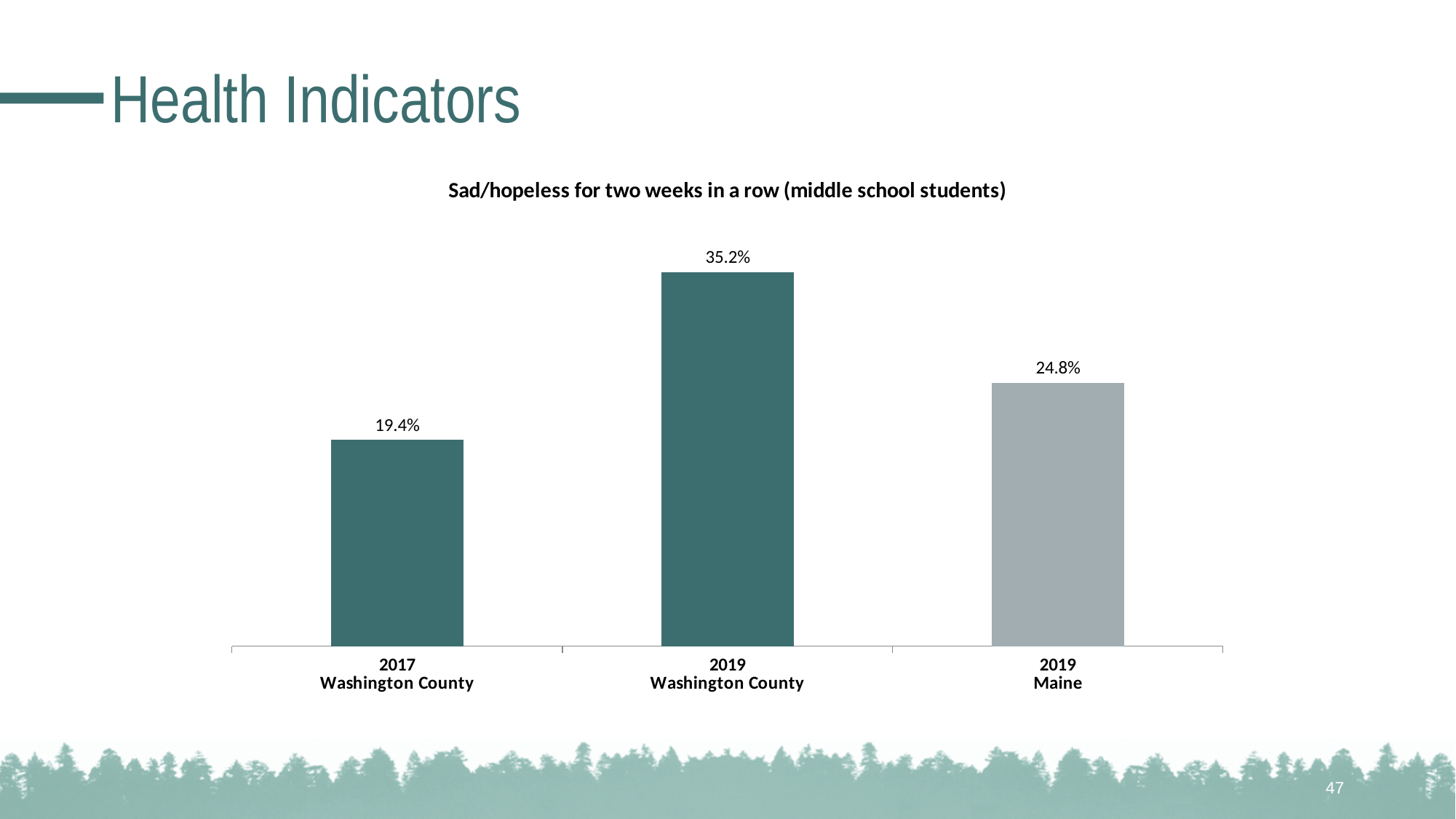
What kind of chart is shown on the slide? Bar chart Did the Washington County value rise or fall from 2017 to 2019? Rise What is the value for 2019 Maine? 24.8% What is the difference between the 2019 Washington County value and the 2017 Washington County value? 15.8% Which is larger, the value for 2019 Maine or the value for 2017 Washington County? 2019 Maine Which category has the lowest value? 2017 Washington County What is the difference between the 2019 Washington County value and the 2019 Maine value? 10.4% Which category has the highest value? 2019 Washington County What is the value for 2019 Washington County? 35.2% What is the title of the chart? Sad/hopeless for two weeks in a row (middle school students) What is the value for 2017 Washington County? 19.4% How many bars are shown in the chart? 3